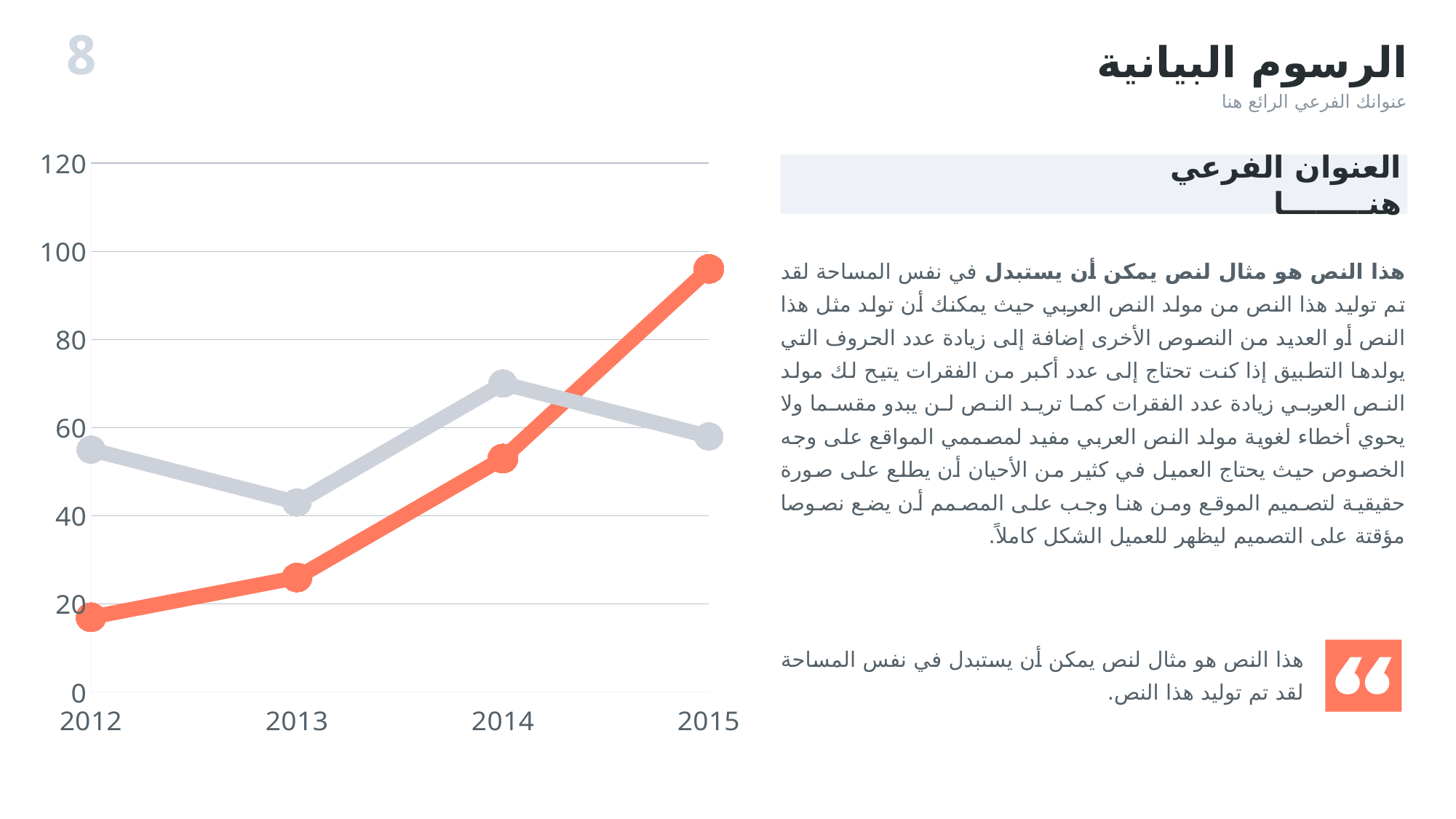
What kind of chart is shown on the slide? line chart In which year does the orange line reach its highest value? 2015 Is the value of the orange line in 2012 greater or less than 20? less In which year does the gray line have its lowest value? 2013 In 2015, which line has the higher value, the orange line or the gray line? the orange line How many years are shown on the x axis of the chart? 4 In which year does the gray line reach its highest value? 2014 How many lines are plotted on the chart? 2 Does the orange line rise or fall from 2012 to 2015? rise In 2013, which line has the higher value, the orange line or the gray line? the gray line Is the value of the orange line in 2015 greater or less than 80? greater In which year does the orange line have its lowest value? 2012